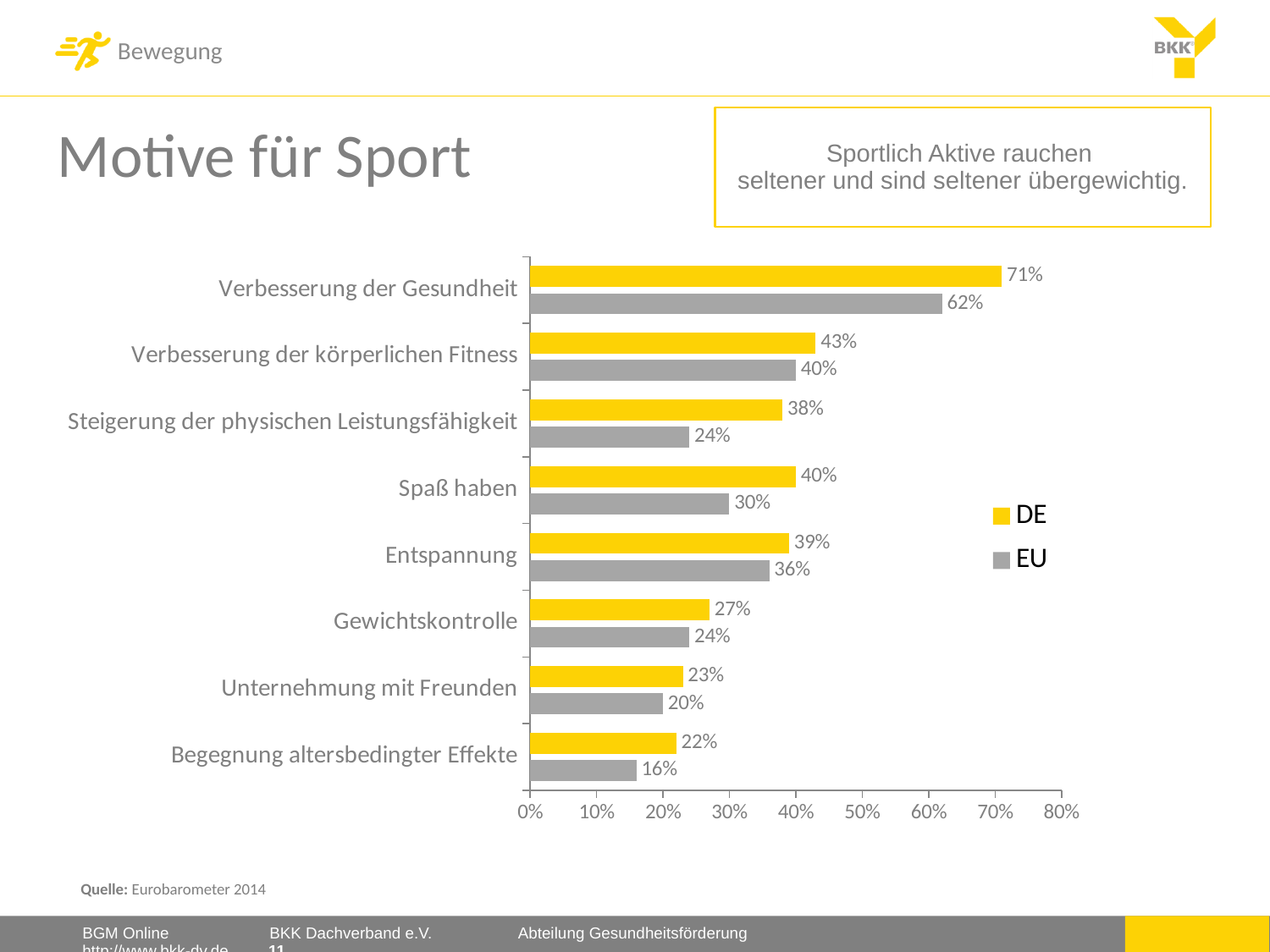
Which category has the highest DE value? Verbesserung der Gesundheit What is the EU value for Begegnung altersbedingter Effekte? 16% Which category has the lowest EU value? Begegnung altersbedingter Effekte What is the EU value for Steigerung der physischen Leistungsfähigkeit? 24% What is the DE value for Verbesserung der Gesundheit? 71% How many categories are shown on the chart? 8 How many series does the legend list? 2 Which colour represents the DE series in the legend? Yellow What kind of chart is shown on the slide? Bar chart What is the difference between the DE and EU values for Verbesserung der Gesundheit? 9% What is the difference between the DE and EU values for Spaß haben? 10% Which is larger for Entspannung, the DE value or the EU value? DE